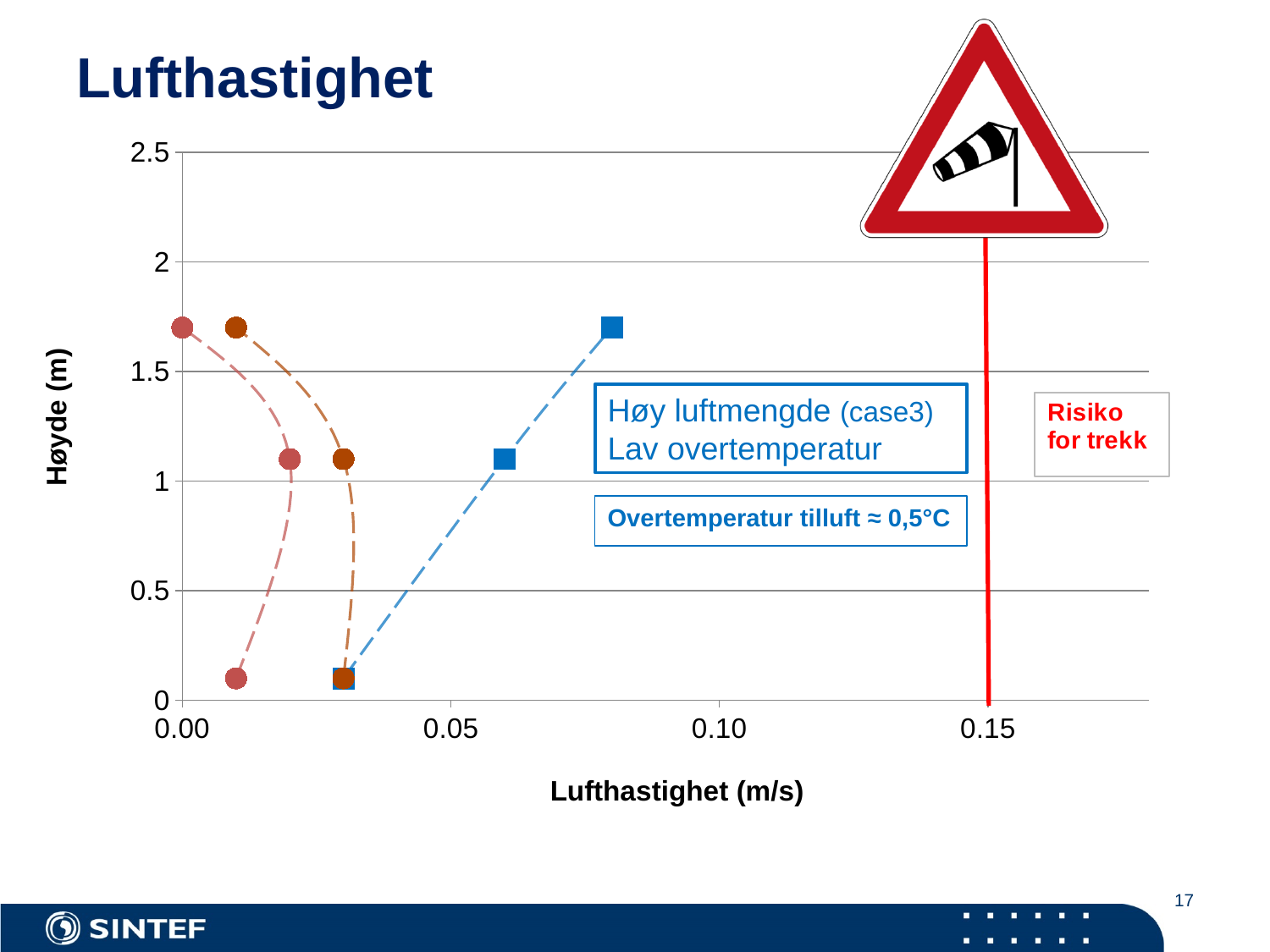
Is the air velocity of the highest blue square point greater or less than 0.10? less What is the maximum value shown on the y axis? 2.5 For the blue square series, does air velocity rise or fall as height increases? Rises Is the air velocity of the brown circle point at about 1.1 m height greater or less than 0.05? less How many data points does the blue square series have? 3 At what air velocity (x value) is the red vertical line drawn? 0.15 What is the label of the y axis? Høyde (m) How many data series are plotted on the chart? 3 What kind of chart is shown on the slide? Scatter chart with lines Which series has the highest air velocity at the top height of about 1.7 m: the blue squares or the brown circles? Blue squares What is the label of the x axis? Lufthastighet (m/s) Is the air velocity of the highest blue square point greater or less than 0.05? greater